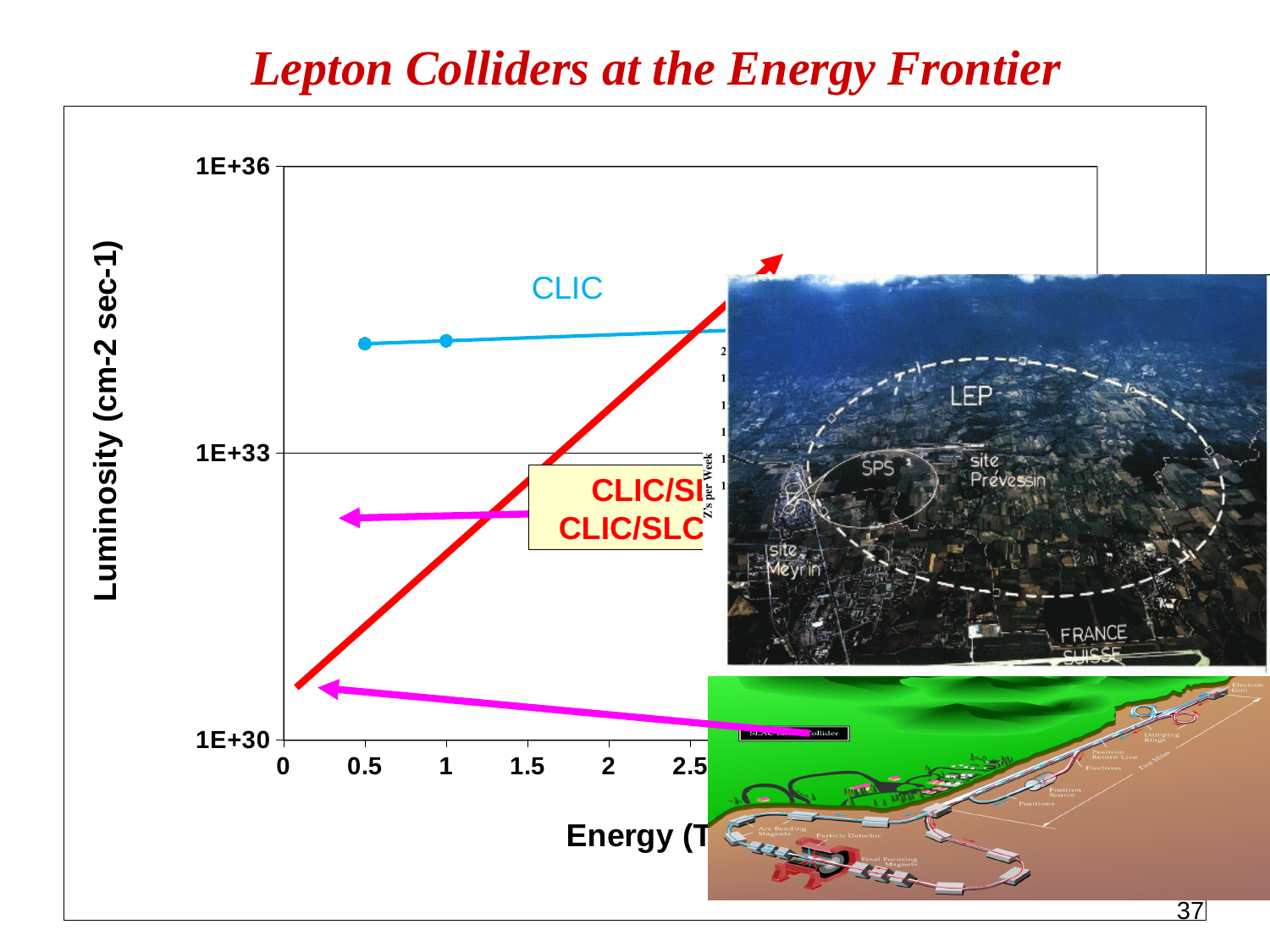
Is the value of the red line at the left end of the x axis (near 0) greater or less than 1E+33? less What is the highest tick value printed on the luminosity axis? 1E+36 Is the CLIC luminosity at 1 TeV greater or less than 1E+36? less Does the red line rise or fall as energy increases along the x axis? rise What is the lowest tick value printed on the luminosity axis? 1E+30 What kind of chart is shown on the slide? line chart Is the CLIC luminosity at 0.5 TeV greater or less than 1E+33? greater Which series is labelled in blue on the chart? CLIC